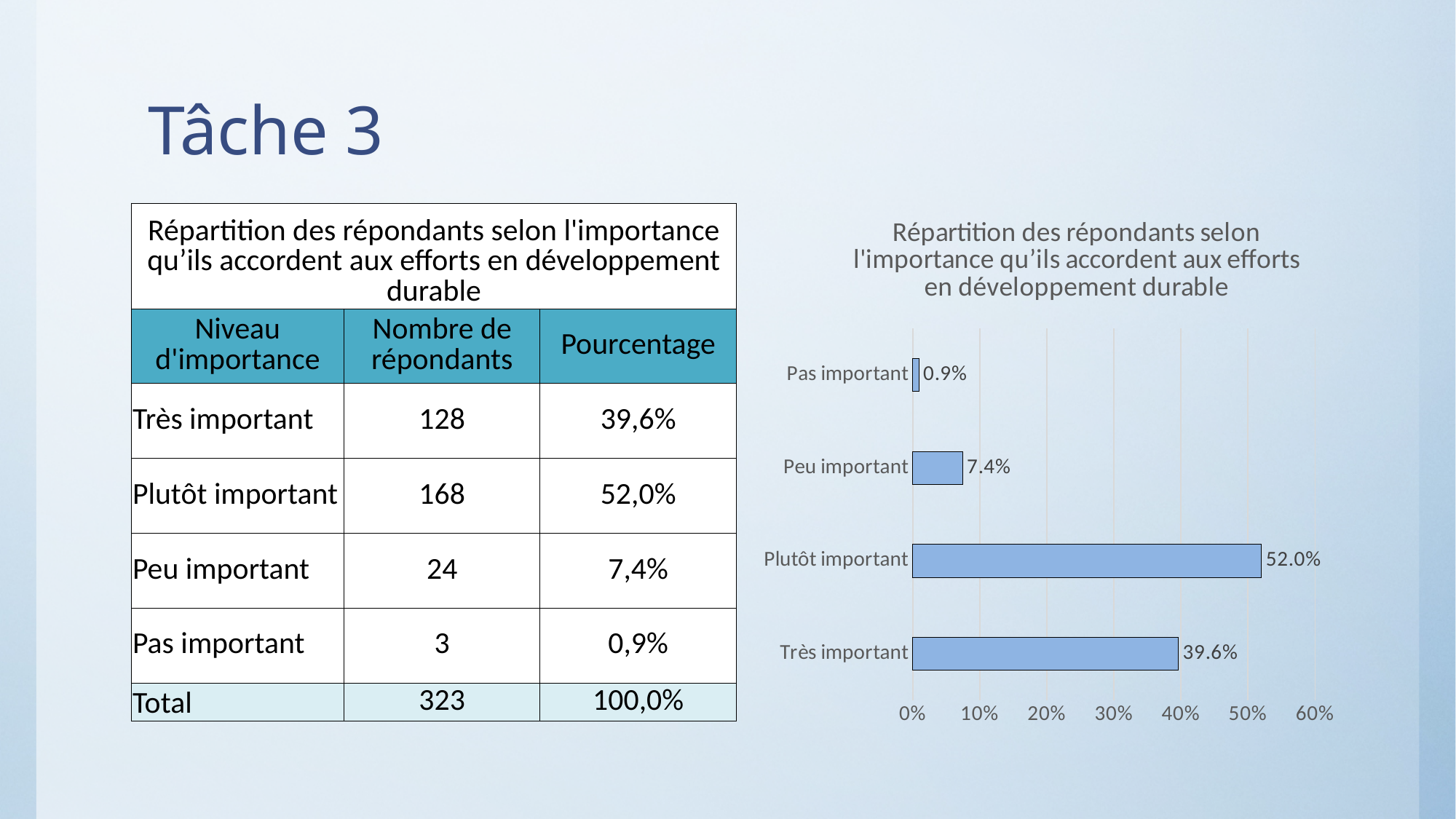
What is the difference between the values for Plutôt important and Très important? 12.4% What is the value for Peu important in the chart? 7.4% Is the value for Très important greater or less than 30%? greater What is the value for Très important in the chart? 39.6% Which category has the lowest value in the chart? Pas important How many categories are shown in the chart? 4 Which category has the highest value in the chart? Plutôt important What kind of chart is shown on the slide? bar chart What is the title of the chart? Répartition des répondants selon l'importance qu'ils accordent aux efforts en développement durable Which is larger, the value for Peu important or the value for Pas important? Peu important What is the value for Pas important in the chart? 0.9% What is the value for Plutôt important in the chart? 52.0%